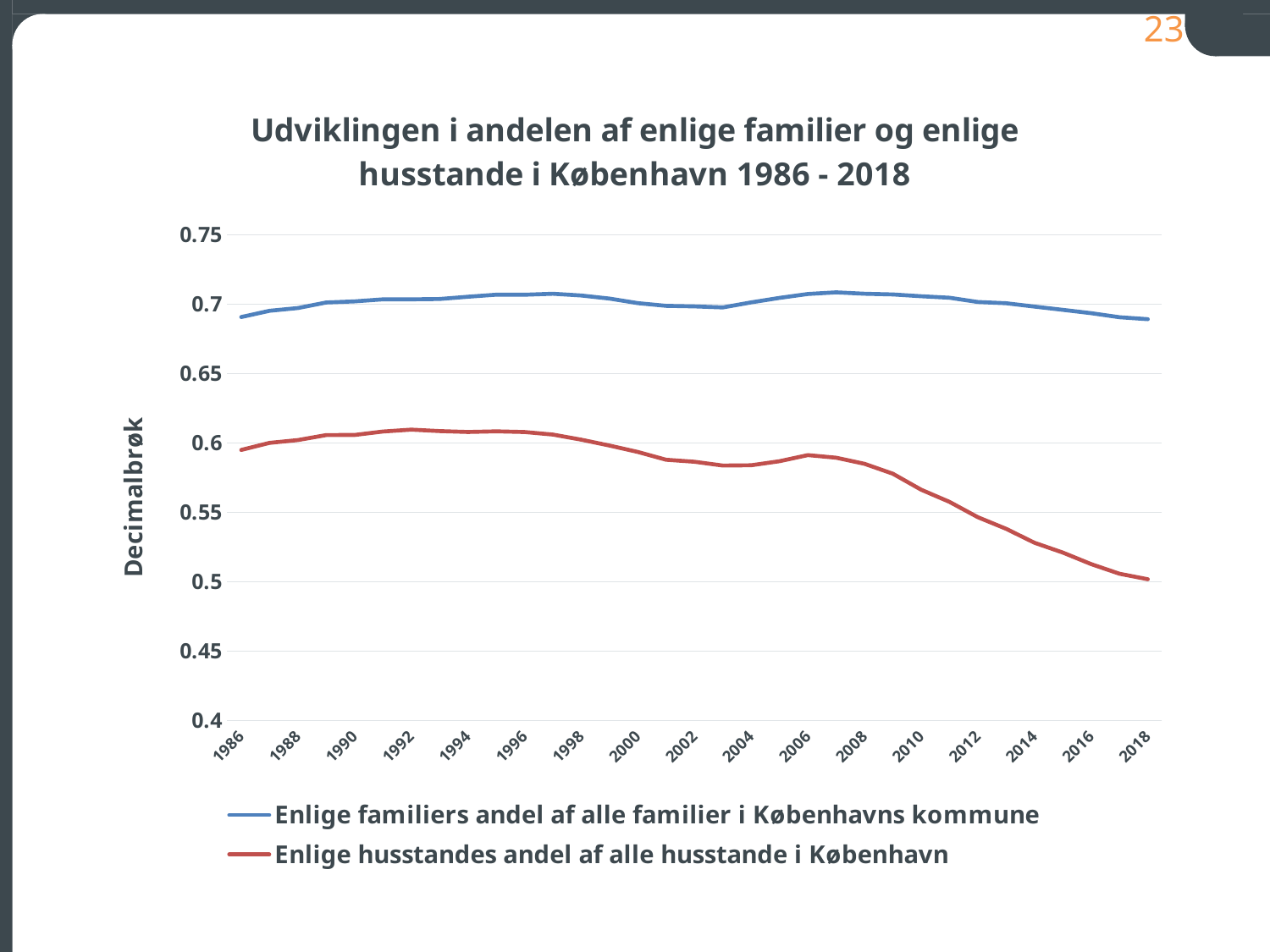
Is the value for 'Enlige husstandes andel af alle husstande i København' in 1992 greater or less than 0.6? greater How many series does the legend list? 2 Is the value for 'Enlige husstandes andel af alle husstande i København' in 2014 greater or less than 0.55? less What kind of chart is shown on the slide? line chart Is the value for 'Enlige husstandes andel af alle husstande i København' in 2010 greater or less than 0.6? less Which series has the higher value in 2018, 'Enlige familiers andel af alle familier i Københavns kommune' or 'Enlige husstandes andel af alle husstande i København'? Enlige familiers andel af alle familier i Københavns kommune How many year labels are shown on the horizontal axis? 17 What is the label on the vertical axis? Decimalbrøk Does the 'Enlige husstandes andel af alle husstande i København' series rise or fall between 2006 and 2018? fall What is the title of the chart? Udviklingen i andelen af enlige familier og enlige husstande i København 1986 - 2018